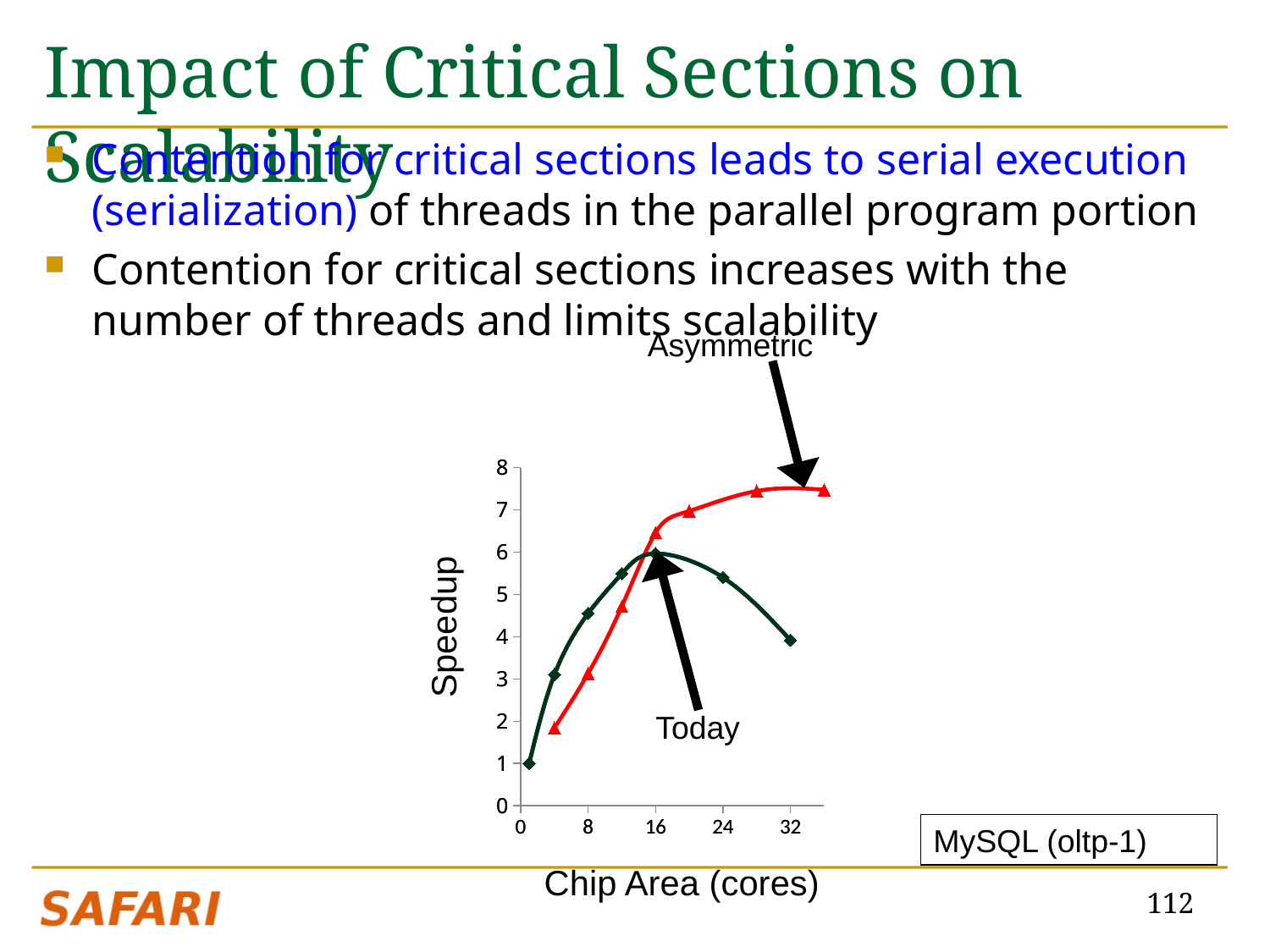
At 8 cores, which line has the higher speedup, Today or Asymmetric? Today What kind of chart is shown on the slide? line chart Is the speedup of the Asymmetric line at 16 cores greater or less than 6? greater Is the speedup of the Today line at 8 cores greater or less than 4? greater Is the speedup of the Today line at 32 cores greater or less than 5? less What is the title of the y axis of the chart? Speedup Does the Asymmetric line rise or fall as chip area increases? rises At 32 cores, which line has the higher speedup, Today or Asymmetric? Asymmetric What is the title of the x axis of the chart? Chip Area (cores) At what chip area does the Today line reach its highest speedup? 16